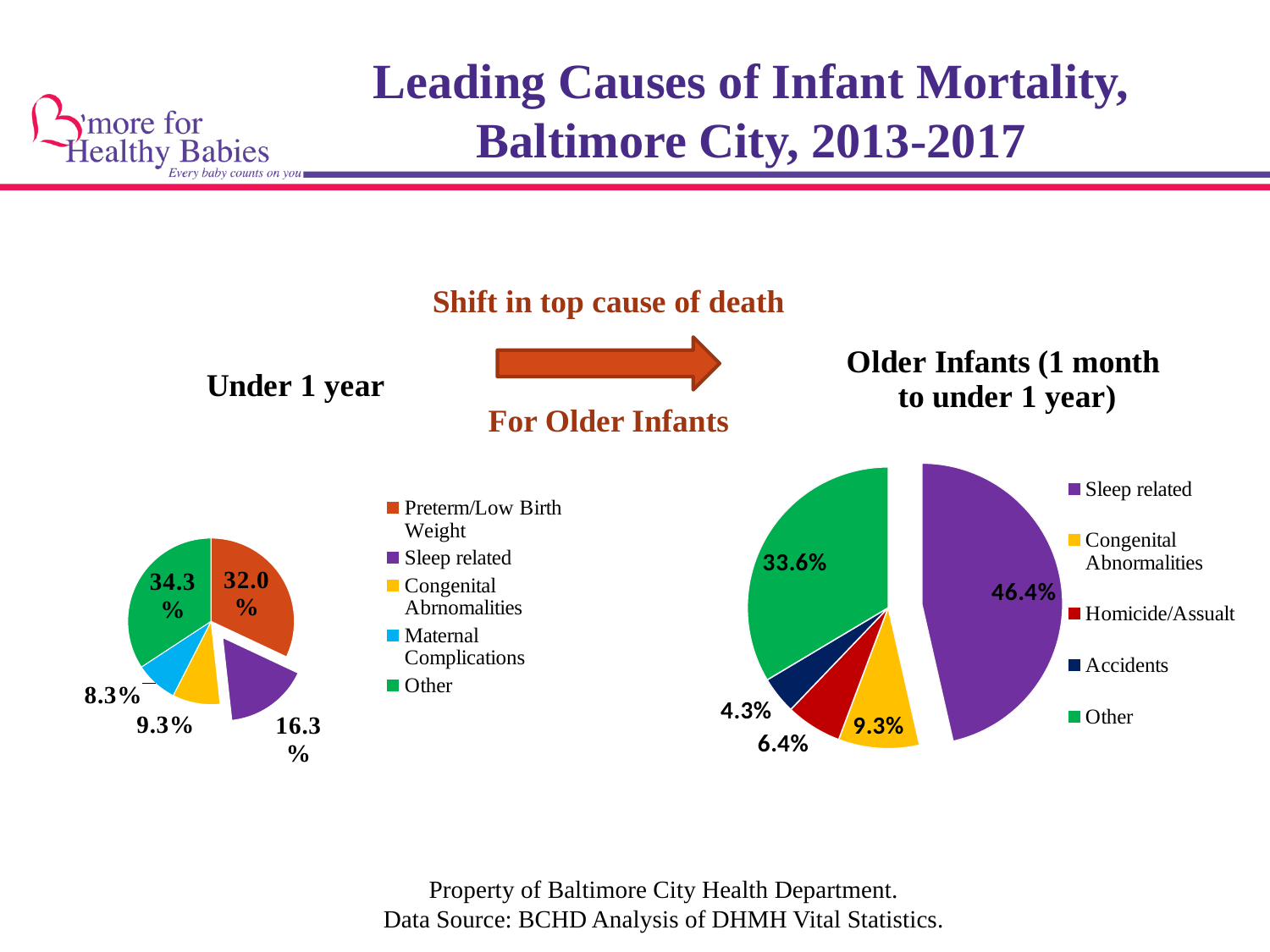
In the 'Under 1 year' pie chart, what share is Preterm/Low Birth Weight? 32.0% In the 'Older Infants (1 month to under 1 year)' pie chart, what share is Sleep related? 46.4% In the 'Under 1 year' pie chart, what share is Maternal Complications? 8.3% In the 'Under 1 year' pie chart, which is larger: Congenital Abnormalities or Maternal Complications? Congenital Abnormalities In the 'Older Infants (1 month to under 1 year)' pie chart, what colour is the Sleep related slice? Purple What type of chart is used for 'Under 1 year'? Pie chart In the 'Older Infants (1 month to under 1 year)' pie chart, which category has the smallest share? Accidents How many categories does the legend of the 'Older Infants (1 month to under 1 year)' chart list? 5 In the 'Under 1 year' pie chart, what share is Sleep related? 16.3% In the 'Under 1 year' pie chart, which category has the largest share? Other In the 'Older Infants (1 month to under 1 year)' pie chart, what is the difference between the Sleep related share and the Other share? 12.8% In the 'Older Infants (1 month to under 1 year)' pie chart, what share is Homicide/Assault? 6.4%